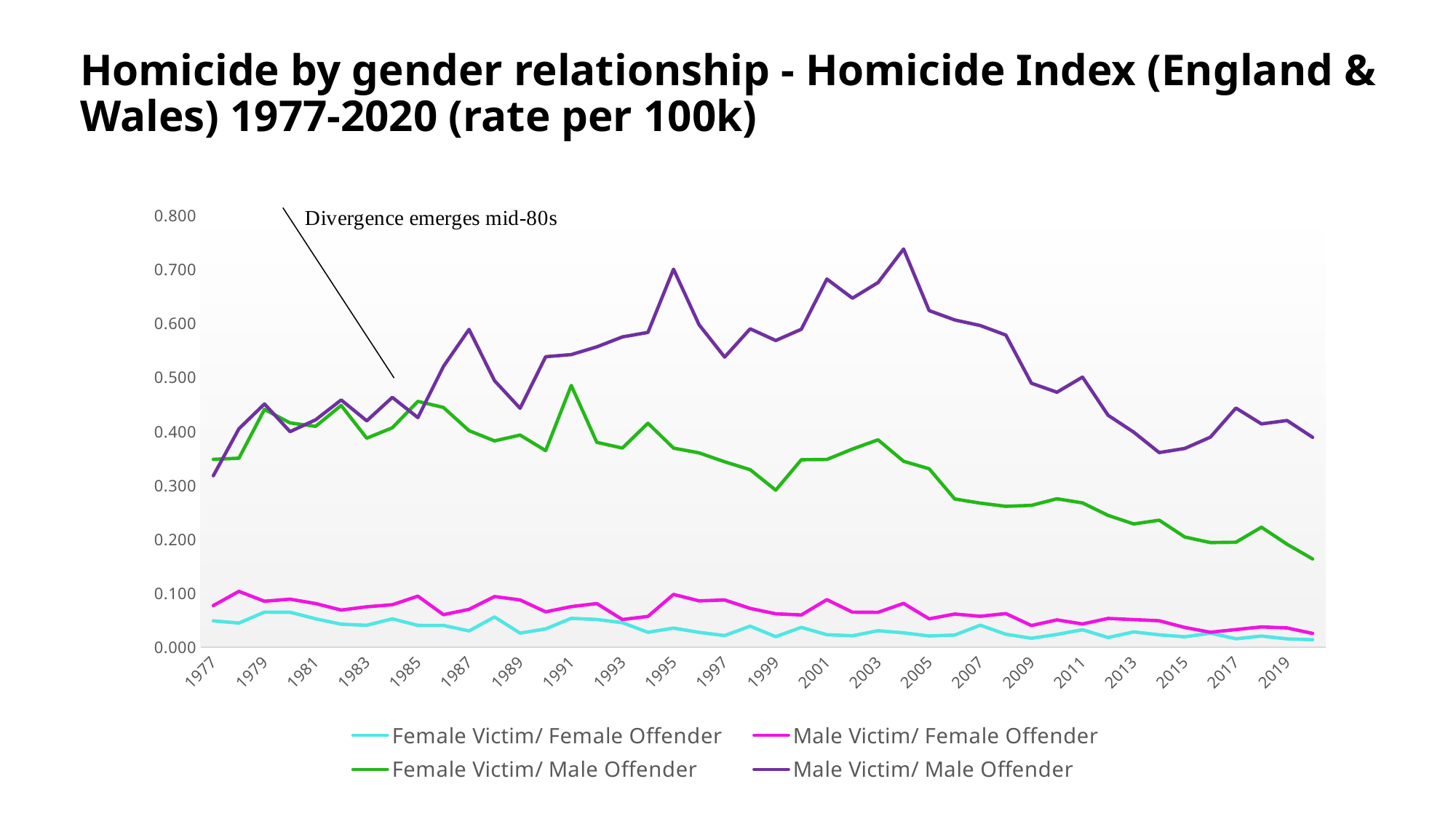
Which series has the highest value in 2004? Male Victim/ Male Offender Which series stays lowest across the whole period? Female Victim/ Female Offender How many series does the legend list? 4 Is the value for Female Victim/ Female Offender in 1977 greater or less than 0.100? less Is the value for Male Victim/ Male Offender in 2014 greater or less than 0.400? less Is the value for Female Victim/ Male Offender in 2020 greater or less than 0.200? less What is the highest value shown on the vertical axis? 0.800 Does the Female Victim/ Male Offender series rise or fall from 2004 to 2020? Fall In 2010, which is larger: Male Victim/ Male Offender or Female Victim/ Male Offender? Male Victim/ Male Offender What kind of chart is shown on the slide? Line chart What does the annotation on the chart say? Divergence emerges mid-80s